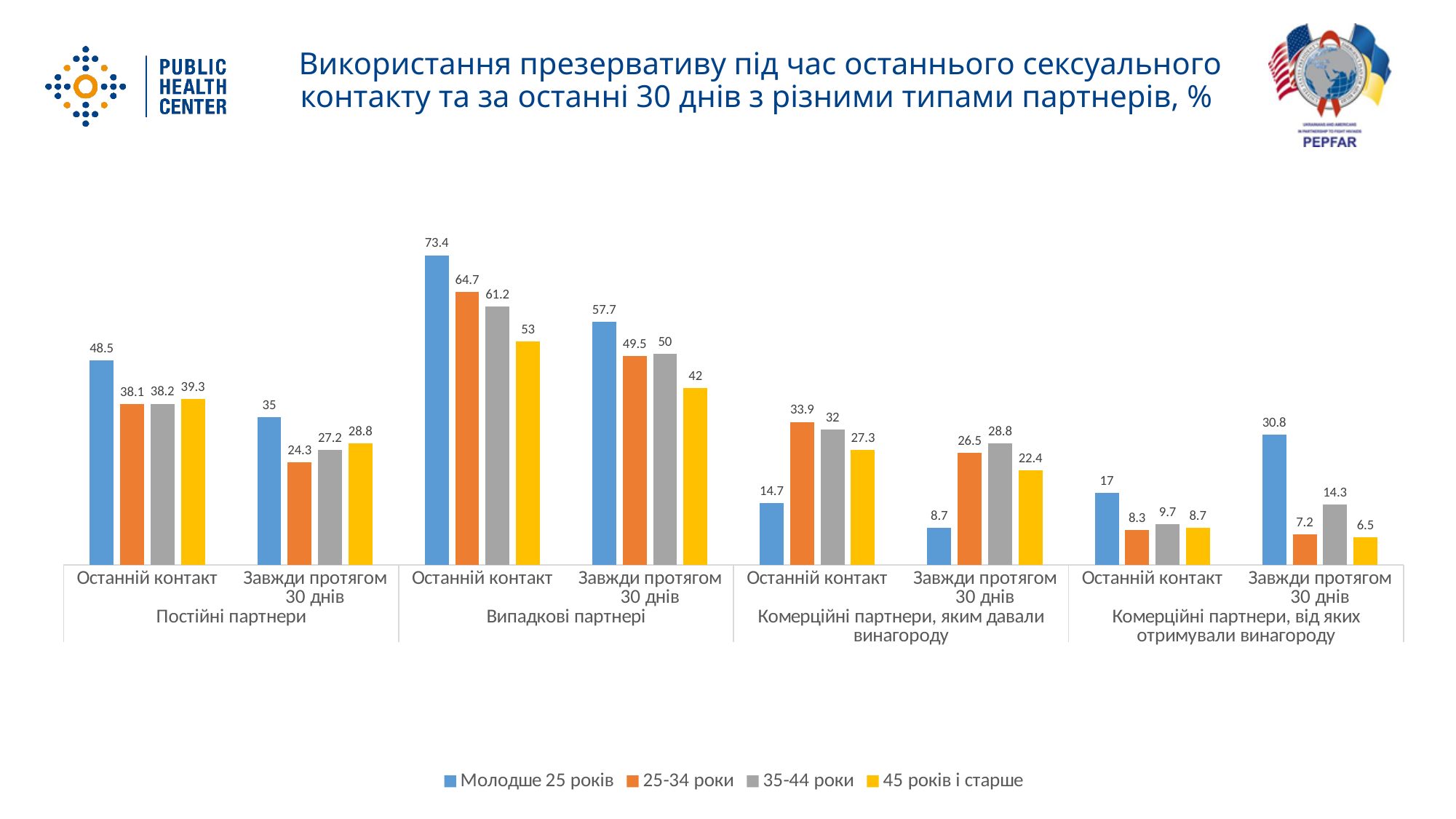
What is the difference between the 'Молодше 25 років' and '25-34 роки' values for 'Останній контакт' among 'Постійні партнери'? 10.4 What is the value for '45 років і старше' for 'Завжди протягом 30 днів' among 'Постійні партнери'? 28.8 Which is larger for 'Завжди протягом 30 днів' among 'Випадкові партнери': the value for '35-44 роки' or for '45 років і старше'? 35-44 роки What is the value for 'Молодше 25 років' for 'Останній контакт' among 'Випадкові партнери'? 73.4 Which age group has the lowest value for 'Завжди протягом 30 днів' among 'Комерційні партнери, від яких отримували винагороду'? 45 років і старше What is the value for '25-34 роки' for 'Завжди протягом 30 днів' among 'Комерційні партнери, від яких отримували винагороду'? 7.2 How many partner type groups are shown along the x axis? 4 Which colour represents the '45 років і старше' series? Yellow How many series does the legend list? 4 What kind of chart is shown on the slide? Bar chart Which age group has the highest value for 'Останній контакт' among 'Комерційні партнери, яким давали винагороду'? 25-34 роки What is the value for '35-44 роки' for 'Останній контакт' among 'Комерційні партнери, від яких отримували винагороду'? 9.7